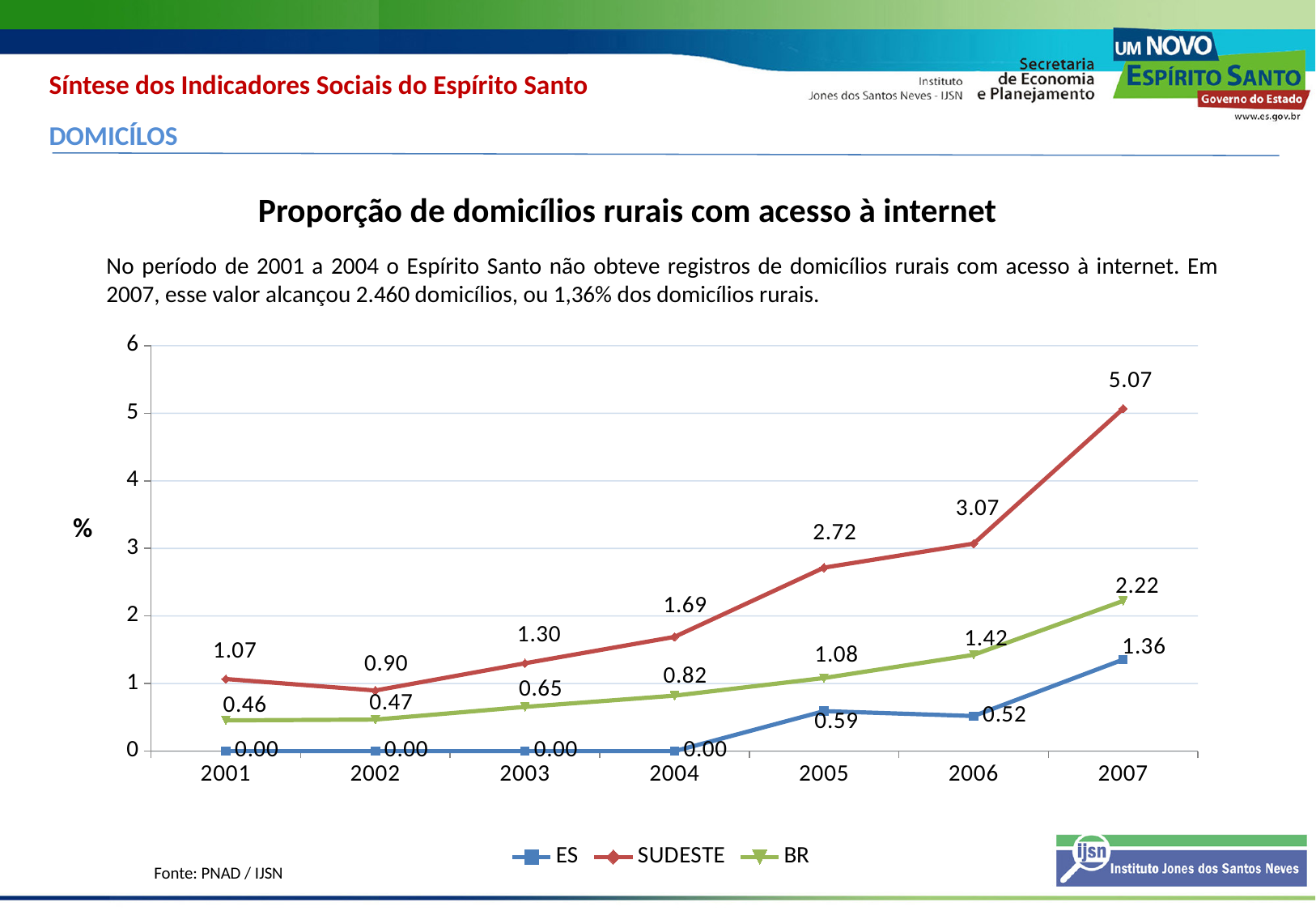
Is the SUDESTE value in 2006 greater or less than 3? greater What is the value for ES in 2005? 0.59 What is the value for BR in 2004? 0.82 In which year is the BR series at its highest? 2007 What is the value for SUDESTE in 2007? 5.07 What kind of chart is shown on the slide? line chart Does the BR series rise or fall from 2002 to 2007? rise How many years are shown on the x axis? 7 Which is larger in 2006, the ES value or the BR value? BR How many series does the legend list? 3 What is the difference between the SUDESTE and BR values in 2007? 2.85 In which year is the SUDESTE series at its lowest? 2002